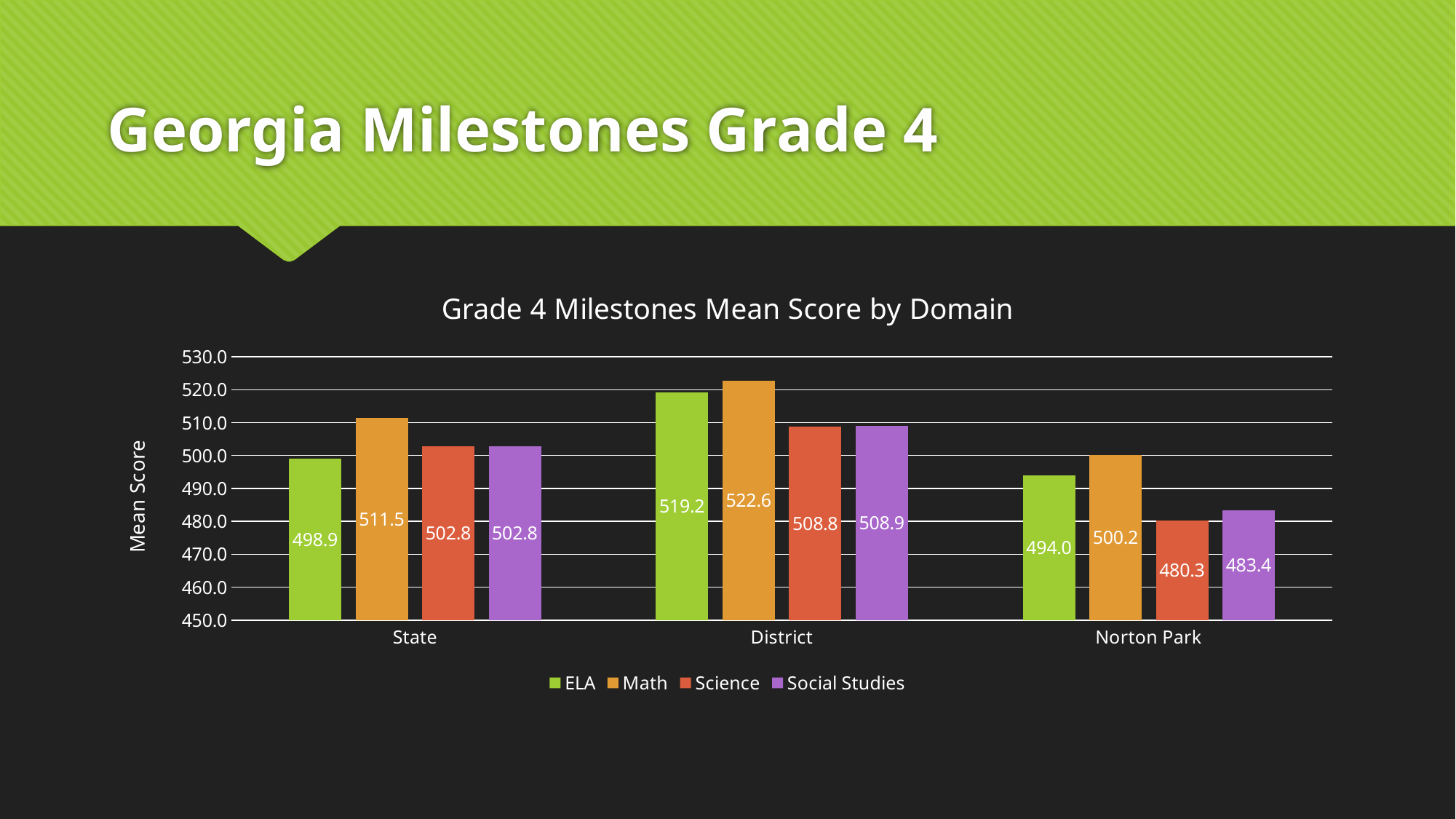
How many series does the legend list? 4 Is the Social Studies mean score for Norton Park greater or less than 490.0? less What kind of chart is shown on the slide? Bar chart What is the ELA mean score for the State? 498.9 Which domain has the highest mean score for Norton Park? Math Which is larger, the State Math mean score or the Norton Park Math mean score? State Math What is the title of the chart? Grade 4 Milestones Mean Score by Domain What is the Science mean score for Norton Park? 480.3 How many groups (categories) are shown on the x axis? 3 What is the difference between the District and Norton Park ELA mean scores? 25.2 What is the Math mean score for the District? 522.6 Which domain has the lowest mean score for the District? Science